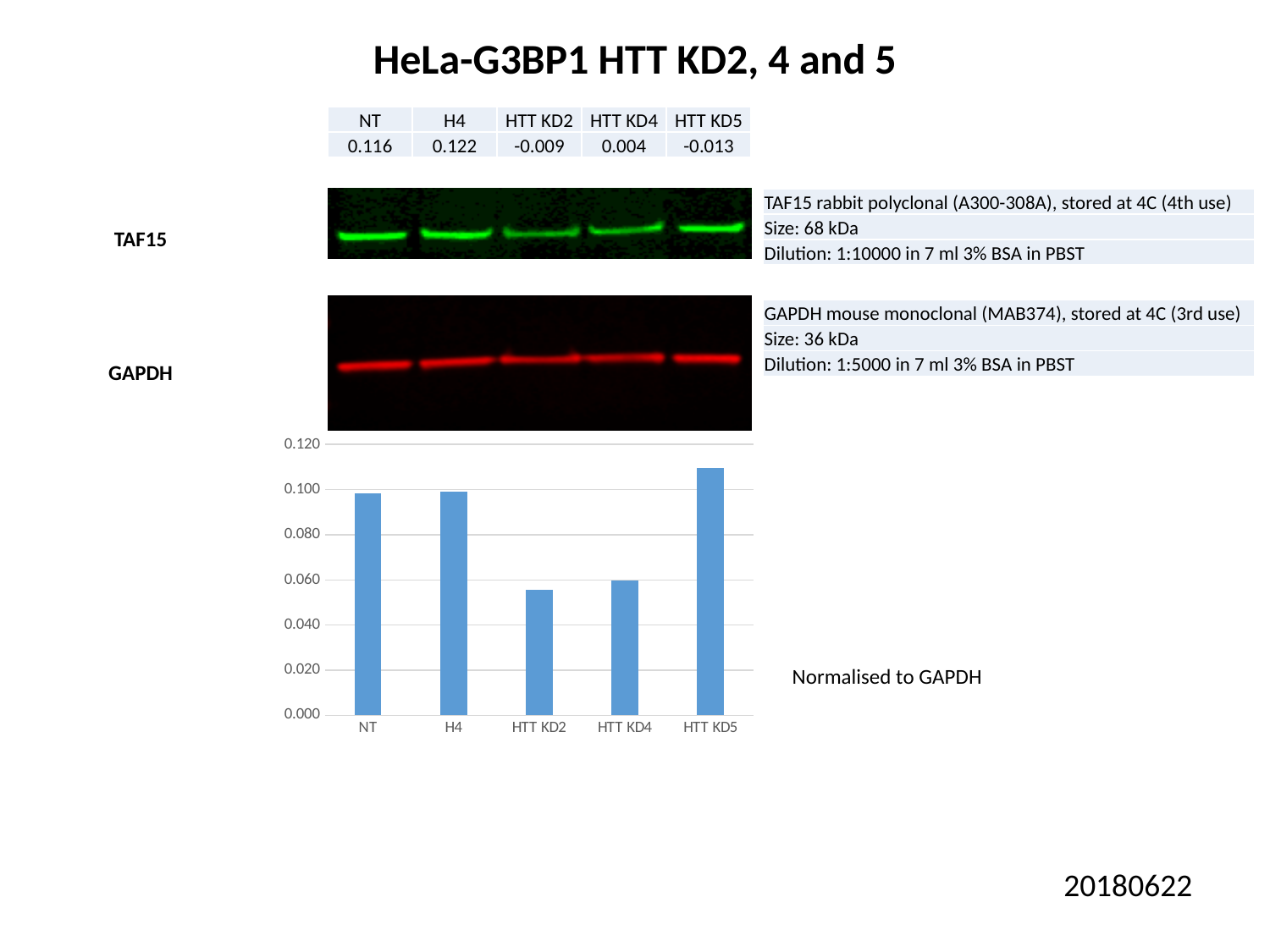
Which has the larger value in the chart, HTT KD5 or H4? HTT KD5 Is the value for HTT KD5 greater or less than 0.100? greater Is the value for HTT KD2 greater or less than 0.060? less What text is written to the right of the bar chart describing the normalisation? Normalised to GAPDH How many categories are plotted on the x axis of the bar chart? 5 What colour are the bars in the chart? blue Is the value for HTT KD4 greater or less than 0.080? less What kind of chart is shown at the bottom of the slide? bar chart Which category has the highest bar in the chart? HTT KD5 Which has the larger value in the chart, NT or HTT KD2? NT